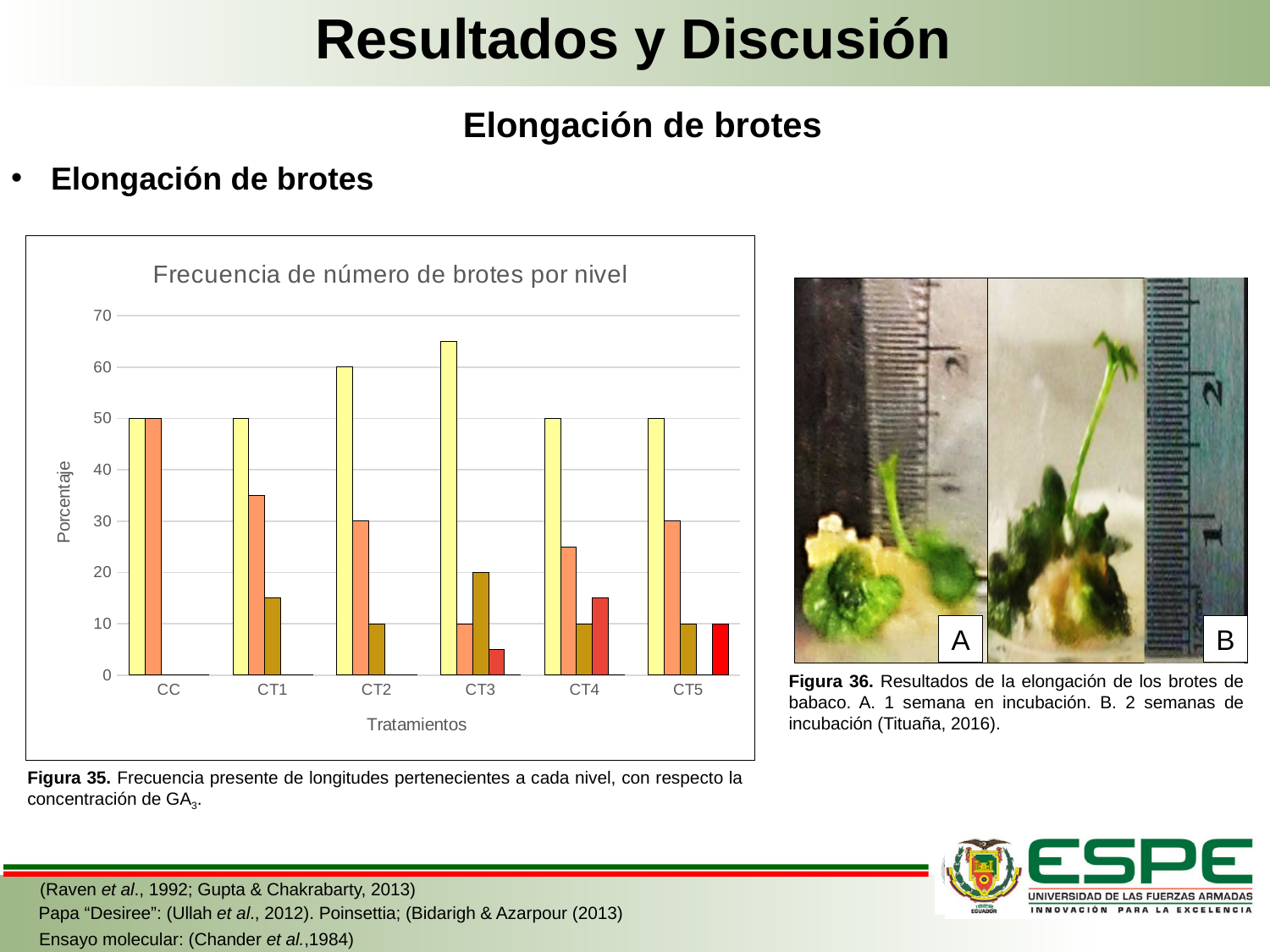
Is the tallest bar for CT1 greater or less than 40? greater How many bars are plotted for CT3? 4 What is the title of the chart? Frecuencia de número de brotes por nivel Is the tallest bar for CT3 greater or less than 60? greater What is the value of the tallest bar for CT2? 60 What is the label of the y axis of the chart? Porcentaje What is the difference between the tallest bar for CT2 and the tallest bar for CC? 10 Which has a taller highest bar, CT2 or CT4? CT2 Which treatment has the tallest bar in the chart? CT3 What type of chart is shown on the slide? bar chart What is the value of the tallest bar for CC? 50 How many treatments are shown on the x axis of the chart? 6